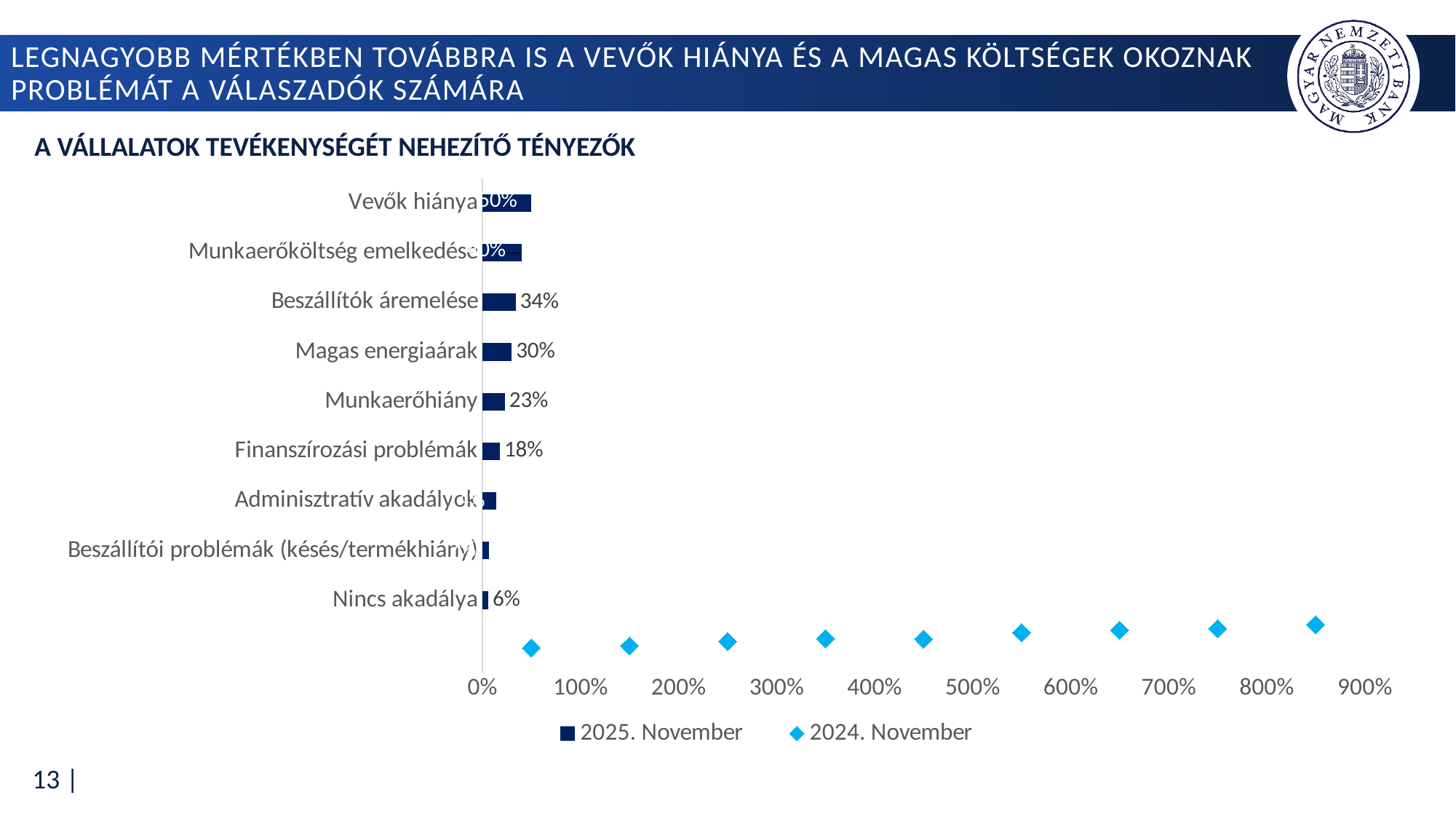
What is the value for Magas energiaárak in the 2025. November series? 30% What is the value for Munkaerőhiány in the 2025. November series? 23% How many categories are shown on the chart? 9 Which category has the longest 2025. November bar? Vevők hiánya What kind of chart is used for the 2025. November series? Bar chart What is the value for Beszállítók áremelése in the 2025. November series? 34% What is the value for Nincs akadálya in the 2025. November series? 6% How many series does the legend list? 2 Is the 2025. November value for Vevők hiánya greater or less than 100%? less Which is larger in the 2025. November series: Munkaerőhiány or Finanszírozási problémák? Munkaerőhiány What is the difference between the 2025. November values for Beszállítók áremelése and Magas energiaárak? 4 percentage points What is the value for Finanszírozási problémák in the 2025. November series? 18%